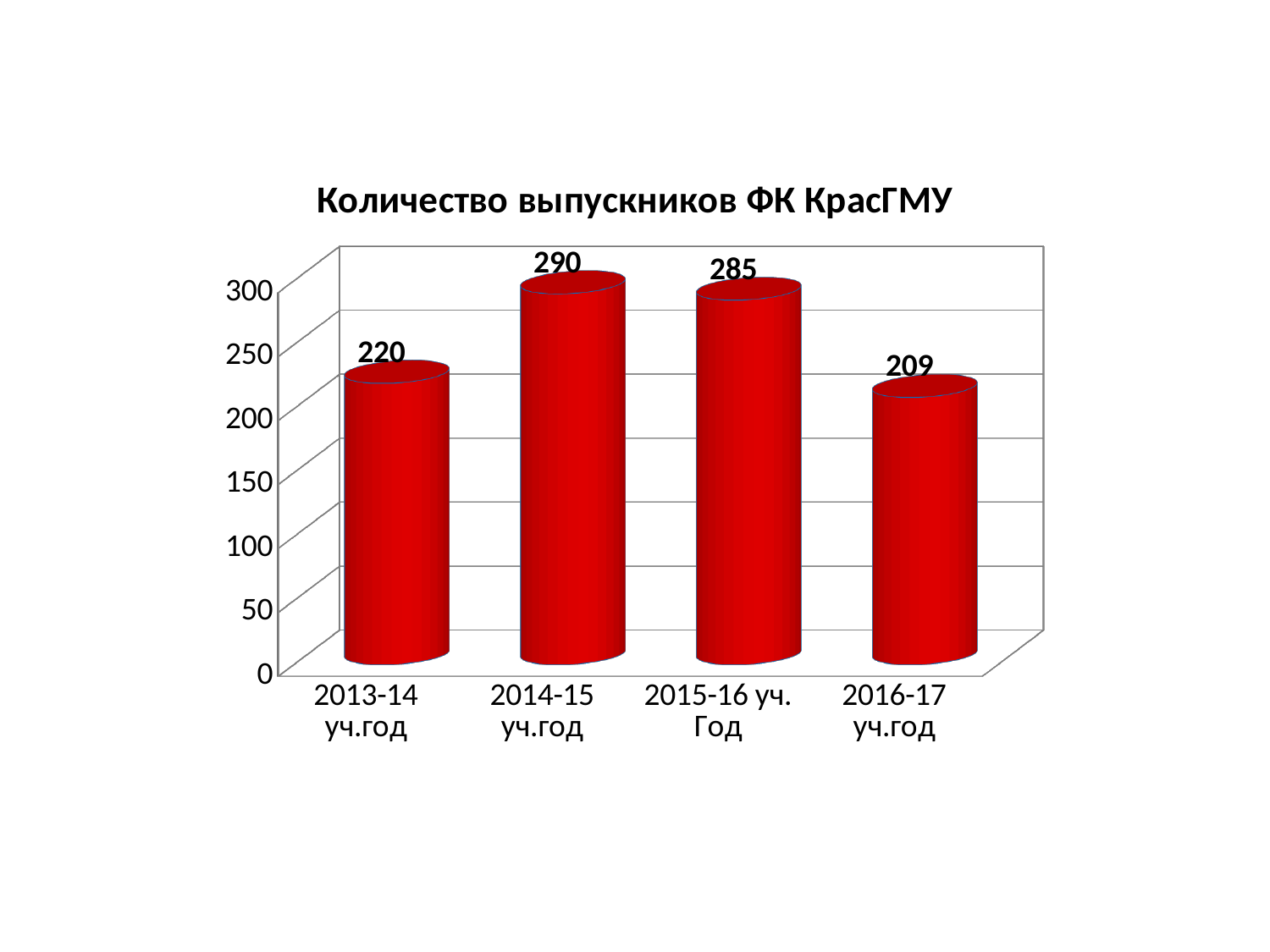
Which academic year has the highest number of graduates? 2014-15 уч.год What is the value for 2013-14 уч.год? 220 What is the difference between the values for 2014-15 уч.год and 2016-17 уч.год? 81 Which academic year has the lowest number of graduates? 2016-17 уч.год What is the value for 2016-17 уч.год? 209 What kind of chart is shown on the slide? bar chart What is the title of the chart? Количество выпускников ФК КрасГМУ What is the difference between the values for 2013-14 уч.год and 2016-17 уч.год? 11 Which is larger, the value for 2013-14 уч.год or the value for 2015-16 уч. Год? 2015-16 уч. Год What is the value for 2015-16 уч. Год? 285 How many academic years are shown on the chart? 4 What is the value for 2014-15 уч.год? 290